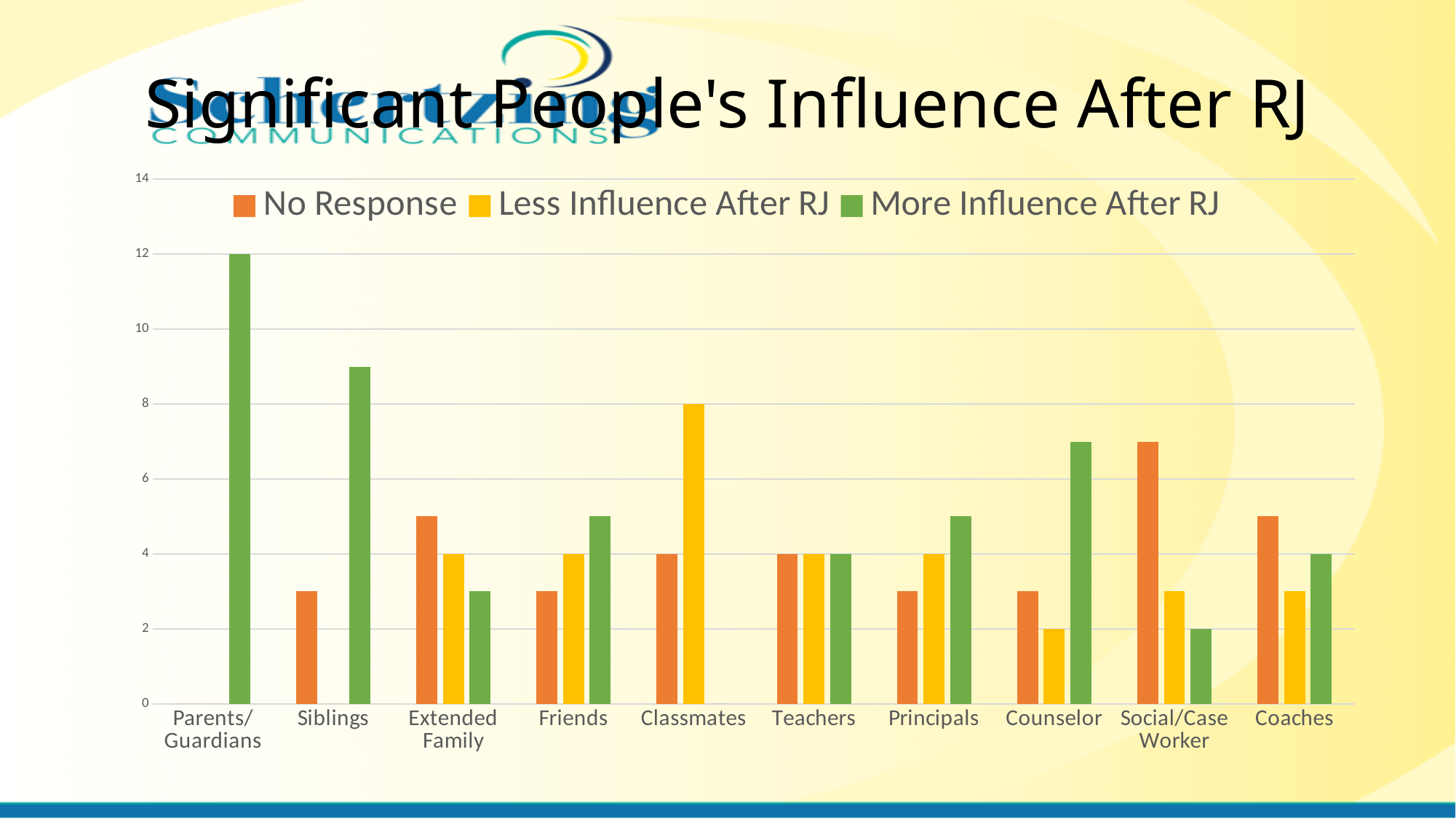
Which category has the highest No Response value? Social/Case Worker What is the Less Influence After RJ value for Classmates? 8 How many series does the legend list? 3 Is the More Influence After RJ value for Siblings greater or less than 8? greater Which category has the highest More Influence After RJ value? Parents/Guardians What is the More Influence After RJ value for Parents/Guardians? 12 Which is larger for Counselor: the More Influence After RJ value or the No Response value? More Influence After RJ Which category has the highest Less Influence After RJ value? Classmates What is the difference between the Less Influence After RJ and No Response values for Classmates? 4 What type of chart is shown on the slide? Bar chart How many categories are shown along the x axis? 10 What is the Less Influence After RJ value for Counselor? 2